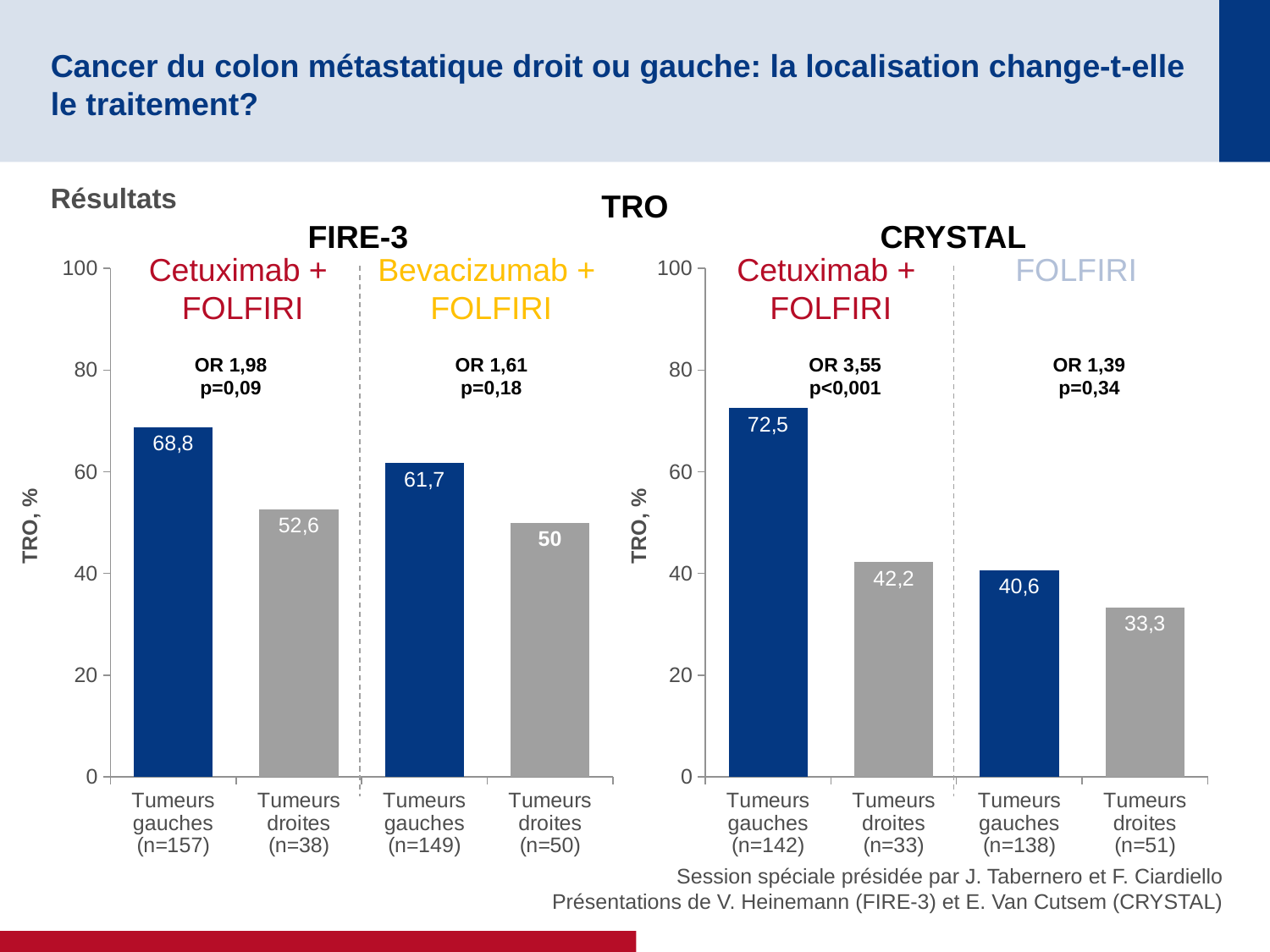
In the CRYSTAL chart, which bar has the highest TRO value? Tumeurs gauches (n=142), Cetuximab + FOLFIRI In the CRYSTAL chart, which is larger: the TRO for right-sided tumours with Cetuximab + FOLFIRI or the TRO for left-sided tumours with FOLFIRI alone? Right-sided tumours with Cetuximab + FOLFIRI (42,2) In the CRYSTAL chart, what is the TRO value for left-sided tumours (Tumeurs gauches, n=142) treated with Cetuximab + FOLFIRI? 72,5 In the FIRE-3 chart, what is the difference in TRO between left-sided and right-sided tumours in the Cetuximab + FOLFIRI arm? 16,2 What type of chart is used for the CRYSTAL results? Bar chart In the FIRE-3 chart, which bar has the lowest TRO value? Tumeurs droites (n=50), Bevacizumab + FOLFIRI In the FIRE-3 chart, what is the TRO value for right-sided tumours (Tumeurs droites, n=50) treated with Bevacizumab + FOLFIRI? 50 How many bars are plotted in the FIRE-3 chart? 4 In the CRYSTAL chart, what is the difference in TRO between left-sided tumours treated with Cetuximab + FOLFIRI (72,5) and left-sided tumours treated with FOLFIRI (40,6)? 31,9 In the CRYSTAL chart, what is the TRO value for right-sided tumours (Tumeurs droites, n=51) treated with FOLFIRI alone? 33,3 In the CRYSTAL chart, what odds ratio and p-value are shown for the Cetuximab + FOLFIRI arm? OR 3,55, p<0,001 In the FIRE-3 chart, what is the TRO value for left-sided tumours (Tumeurs gauches, n=157) treated with Cetuximab + FOLFIRI? 68,8